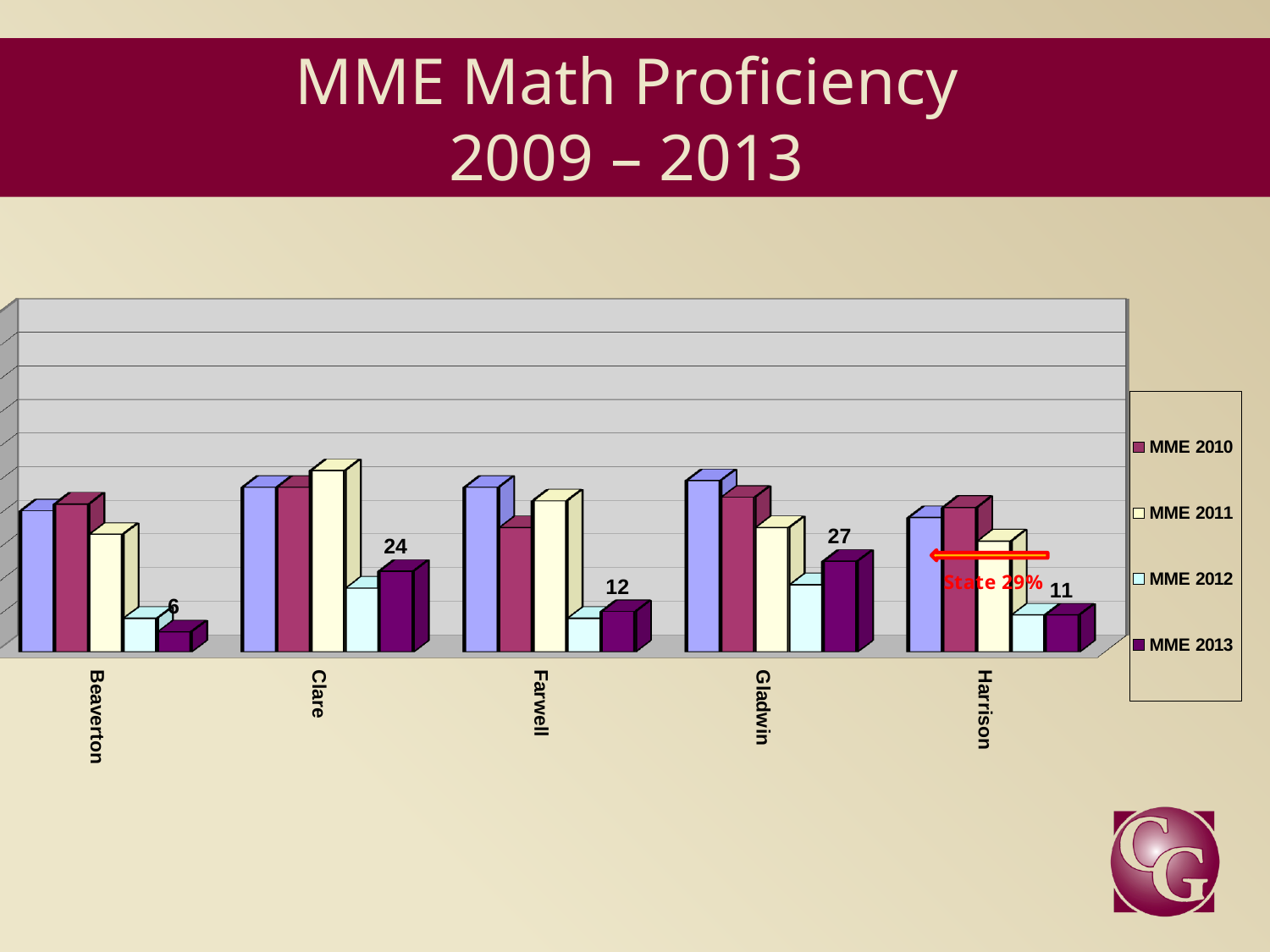
What is the MME 2013 value for Farwell? 12 What is the MME 2013 value for Gladwin? 27 How many schools are shown on the x axis of the chart? 5 What kind of chart is shown on the slide? Bar chart What is the MME 2013 value for Clare? 24 Which school has the highest MME 2013 value? Gladwin Which school has the lowest MME 2013 value? Beaverton Which has the larger MME 2013 value, Farwell or Harrison? Farwell What is the MME 2013 value for Beaverton? 6 What state proficiency percentage is annotated on the chart? 29% What is the difference between the MME 2013 values for Gladwin and Beaverton? 21 What is the MME 2013 value for Harrison? 11